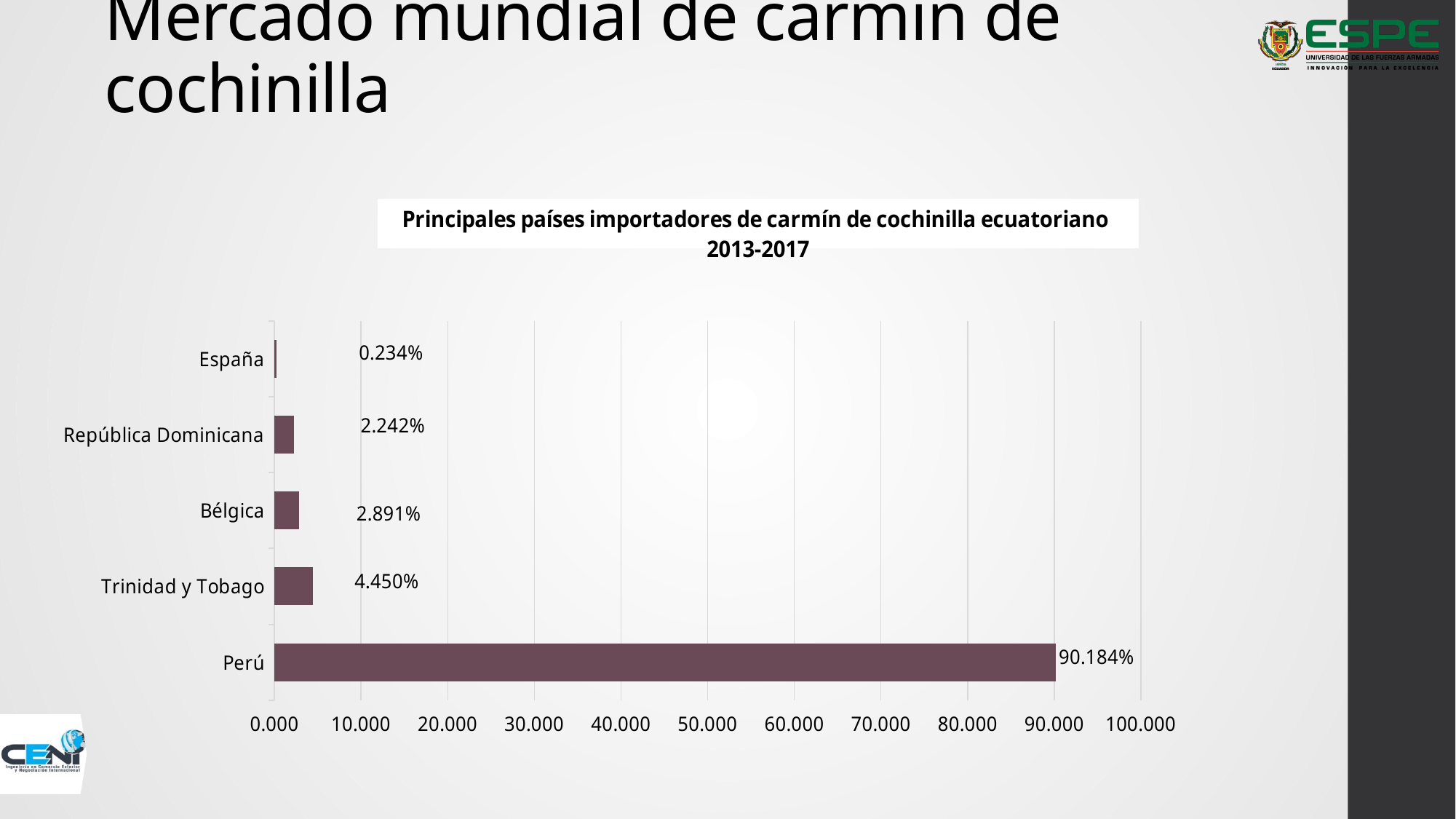
Which is larger, the value for Bélgica or the value for República Dominicana? Bélgica What is the value for Bélgica? 2.891% What is the value for Trinidad y Tobago? 4.450% How many countries are shown in the chart? 5 What is the value for Perú? 90.184% What is the value for España? 0.234% Which country has the highest value? Perú What kind of chart is shown on the slide? bar chart Which country has the lowest value? España Is the value for Perú greater or less than 80.000? greater What is the difference between the values for Perú and Trinidad y Tobago? 85.734% What is the value for República Dominicana? 2.242%